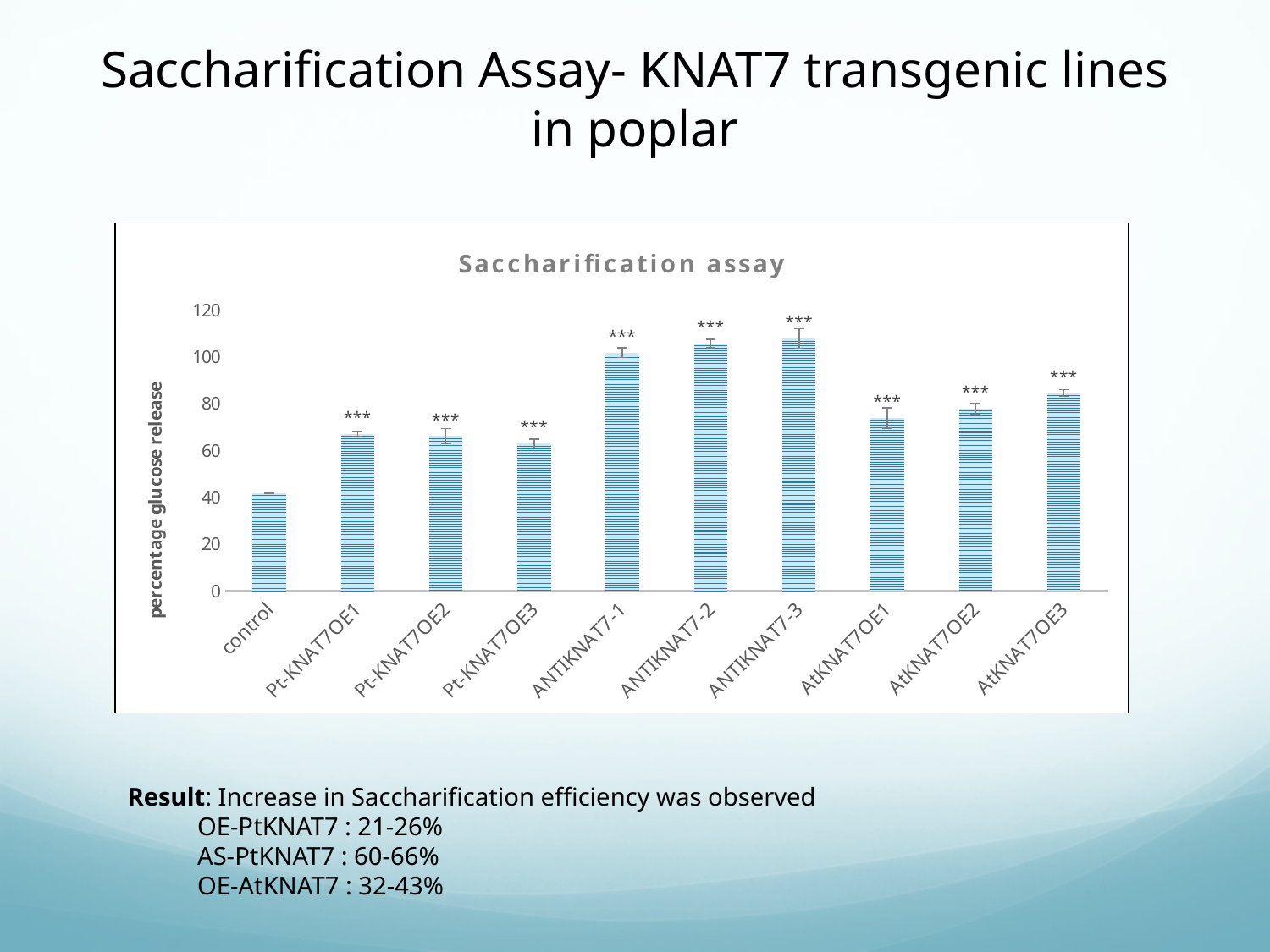
Is the value for ANTIKNAT7-1 greater or less than 80? greater Which category has the lowest percentage glucose release? control Which has the larger value, ANTIKNAT7-1 or Pt-KNAT7OE1? ANTIKNAT7-1 Which has the larger value, AtKNAT7OE3 or Pt-KNAT7OE3? AtKNAT7OE3 Is the value for control greater or less than 60? less How many categories are plotted on the x axis of the chart? 10 What is the label on the y axis of the chart? percentage glucose release What kind of chart is shown on the slide? bar chart Is the value for AtKNAT7OE1 greater or less than 100? less What is the title of the chart? Saccharification assay